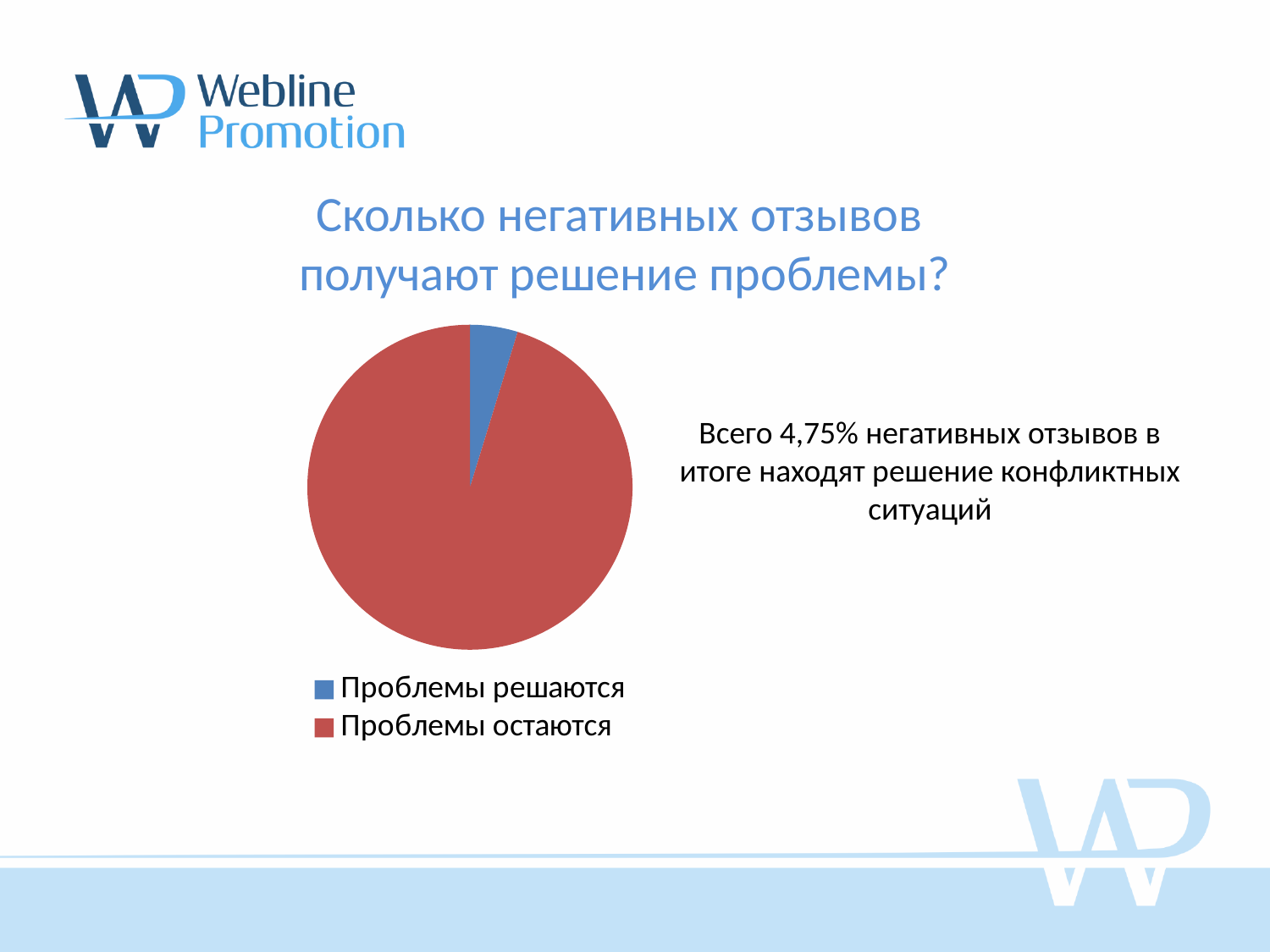
What colour is the "Проблемы остаются" slice in the pie chart? red What is the title above the pie chart? Сколько негативных отзывов получают решение проблемы? What kind of chart is shown on the slide? pie chart How many slices does the pie chart have? 2 Is the share of "Проблемы решаются" greater or less than 25%? less Which category takes the smallest share of the pie chart? Проблемы решаются Is the share of "Проблемы остаются" greater or less than 50%? greater According to the slide, what share of negative reviews end up with the problem resolved ("Проблемы решаются")? 4,75% Which slice is larger: "Проблемы решаются" or "Проблемы остаются"? Проблемы остаются How many entries does the legend of the pie chart list? 2 Which category takes the largest share of the pie chart? Проблемы остаются